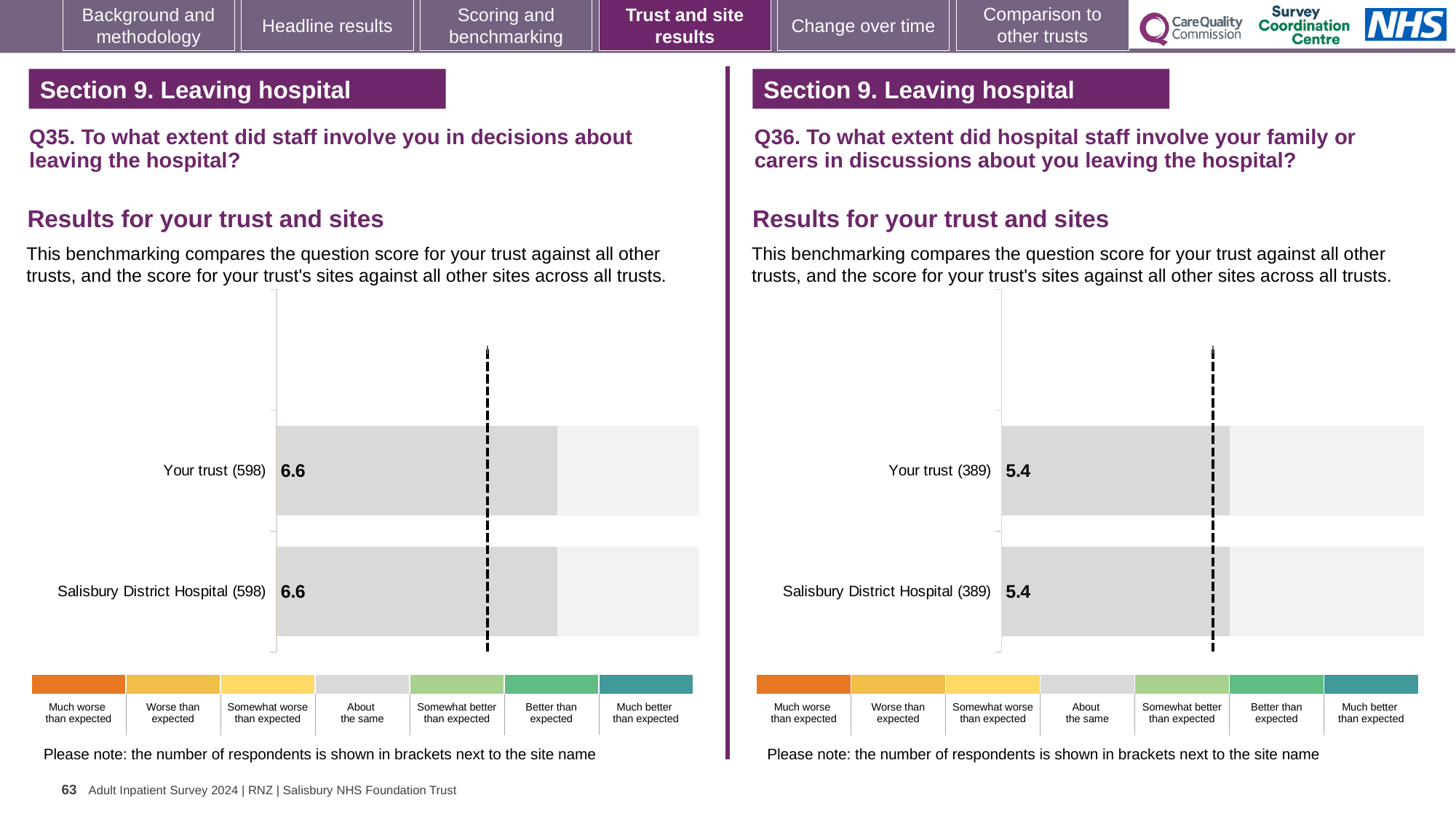
What kind of chart is the Q35 chart on the left? Bar chart In the Q35 chart on the left, how many respondents are shown in brackets next to Your trust? 598 In the Q35 chart on the left, what is the difference between the score for Your trust and the score for Salisbury District Hospital? 0 In the Q36 chart on the right, how many respondents are shown in brackets next to Salisbury District Hospital? 389 How many bars are plotted in the Q36 chart on the right? 2 In the Q35 chart on the left, what is the score for Salisbury District Hospital? 6.6 In the Q36 chart on the right, what is the score for Salisbury District Hospital? 5.4 How many bars are plotted in the Q35 chart on the left? 2 In the Q36 chart on the right, what is the difference between the score for Your trust and the score for Salisbury District Hospital? 0 In the Q36 chart on the right, what is the score for Your trust? 5.4 Is the score for Your trust in the Q35 chart on the left larger than the score for Your trust in the Q36 chart on the right? Yes In the Q35 chart on the left, what is the score for Your trust? 6.6